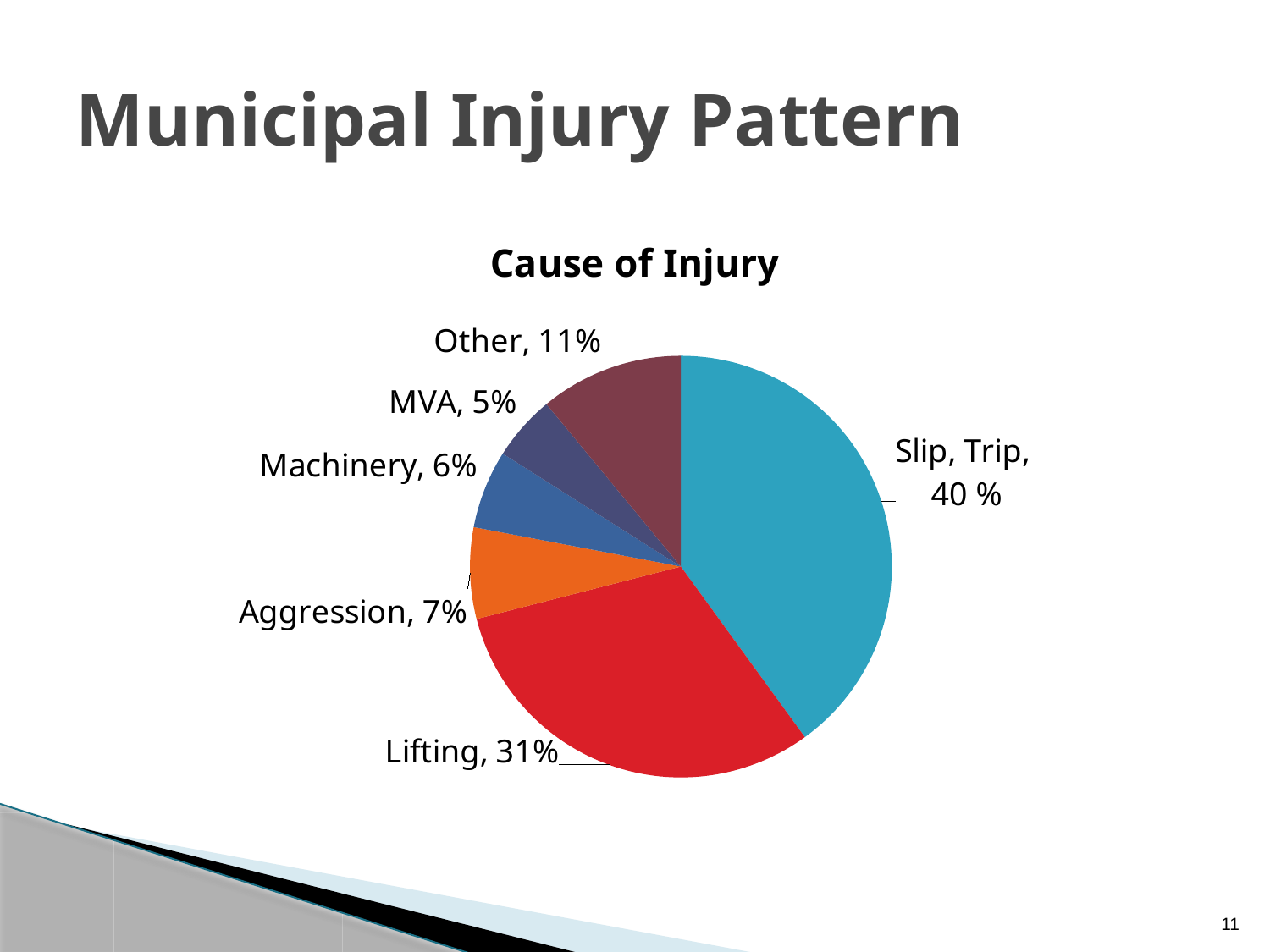
What share of injuries is attributed to Lifting? 31% What is the combined share of Machinery and MVA? 11% What percentage is shown for Aggression? 7% Which cause of injury has the smallest share? MVA What share of injuries is attributed to Slip, Trip? 40 % Which has a larger share, Other or Machinery? Other What type of chart is shown on the slide? pie chart What percentage is shown for MVA? 5% How many slices does the pie chart have? 6 What is the title of the chart? Cause of Injury What is the difference in percentage points between Slip, Trip and Lifting? 9 Which cause of injury has the largest share? Slip, Trip